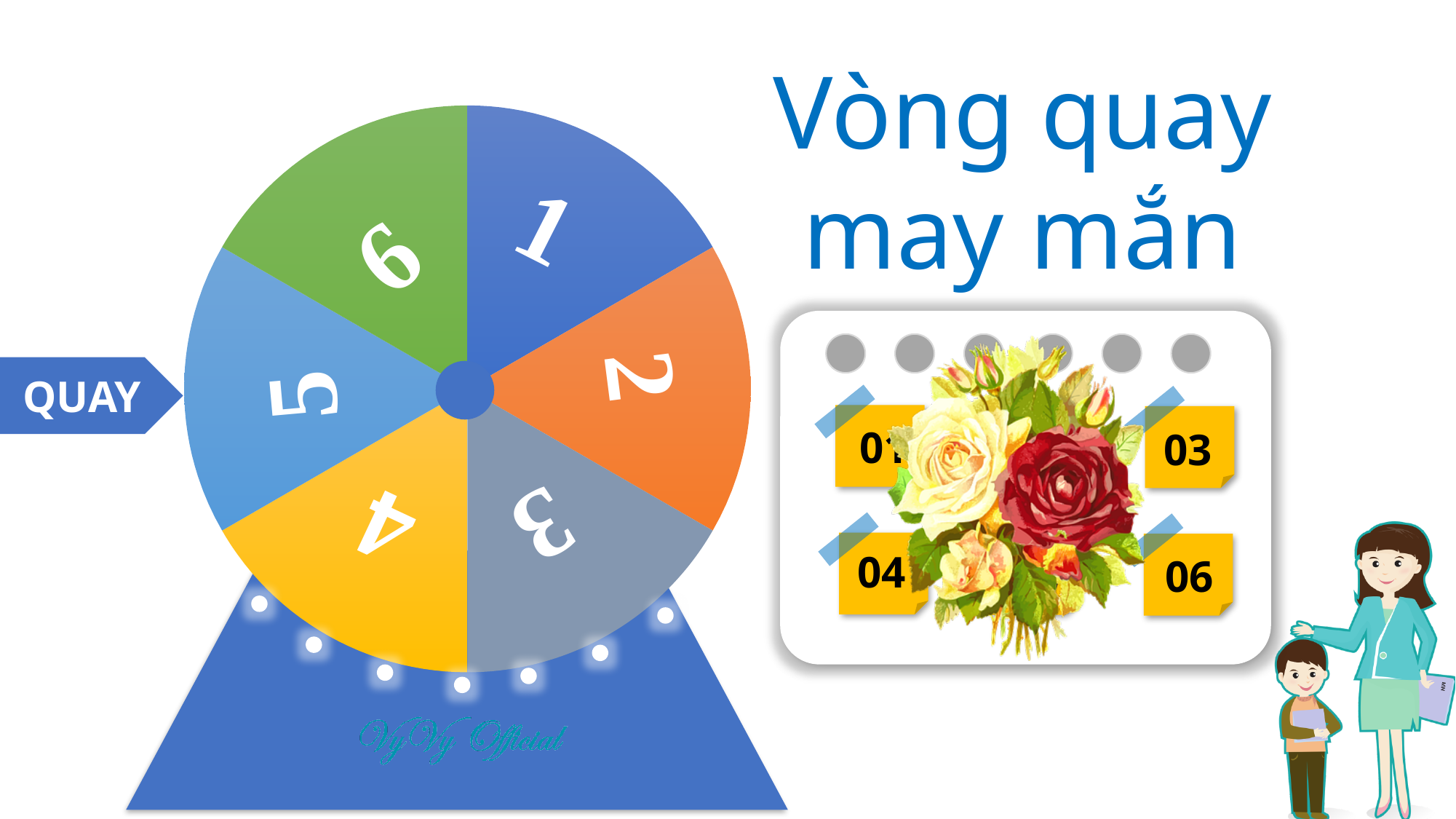
Which number is on the yellow segment of the wheel? 4 What colour is the segment labelled 2 on the wheel? orange How many numbered segments does the wheel on the left have? 6 Which number is on the grey segment of the wheel? 3 What is the lowest number printed on the wheel? 1 Which number is on the green segment of the wheel? 6 What word is written on the blue arrow button to the left of the wheel? QUAY What kind of chart is the wheel on the left drawn as? pie chart What is the title shown at the top right of the slide? Vòng quay may mắn What is the highest number printed on the wheel? 6